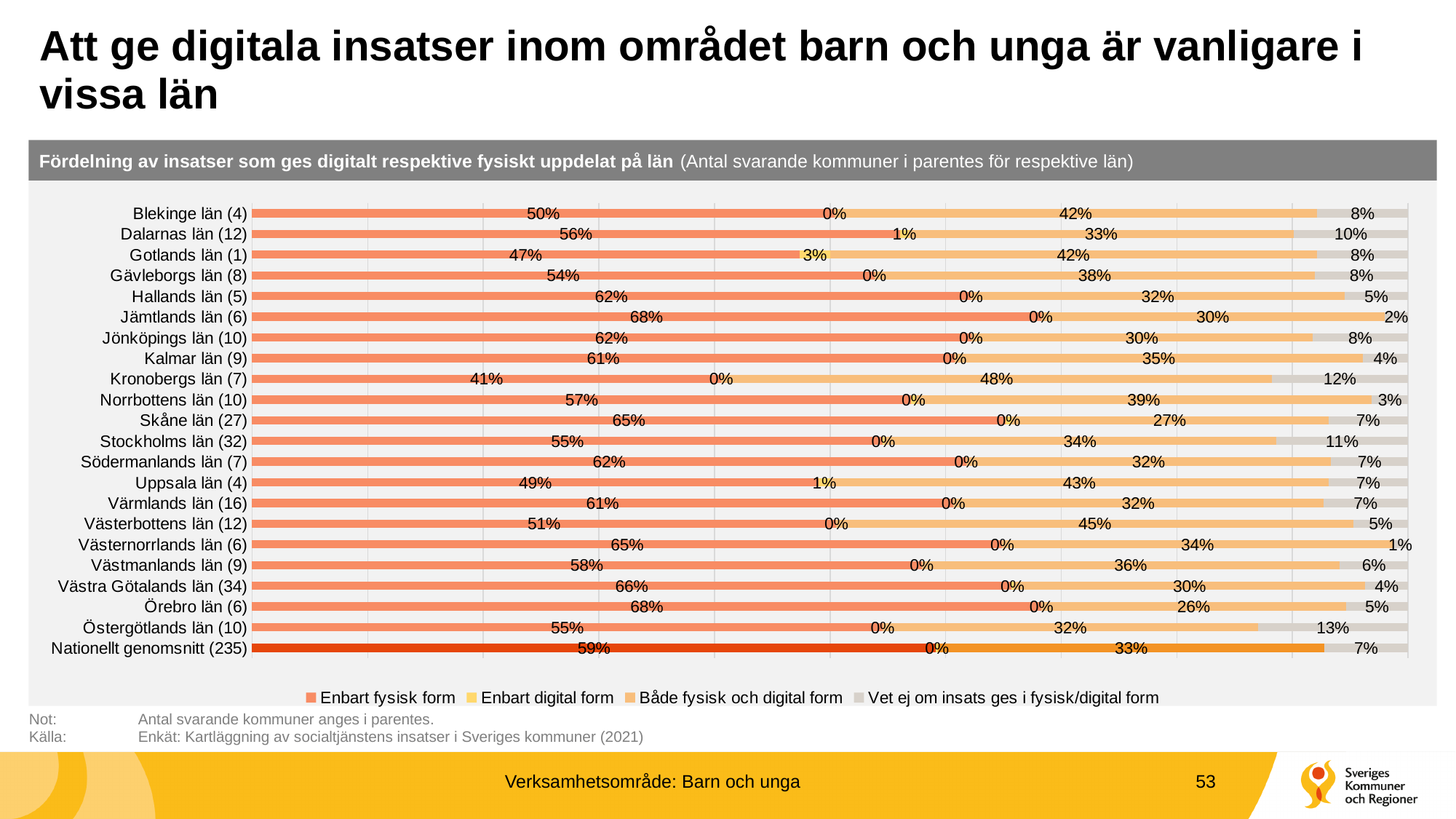
How many categories (bars) are shown in the chart? 22 Which has a larger "Enbart fysisk form" value, Stockholms län (32) or Västra Götalands län (34)? Västra Götalands län (34) What is the value for "Enbart fysisk form" for Kronobergs län (7)? 41% How many series does the legend list? 4 Which category has the lowest value for "Enbart fysisk form"? Kronobergs län (7) What is the value for "Både fysisk och digital form" for Nationellt genomsnitt (235)? 33% What is the value for "Vet ej om insats ges i fysisk/digital form" for Östergötlands län (10)? 13% Which category has the highest value for "Både fysisk och digital form"? Kronobergs län (7) What kind of chart is shown on the slide? Stacked bar chart What is the difference between the "Både fysisk och digital form" values for Kronobergs län (7) and Skåne län (27)? 21 percentage points What is the value for "Enbart digital form" for Gotlands län (1)? 3% Which category has the highest value for "Vet ej om insats ges i fysisk/digital form"? Östergötlands län (10)